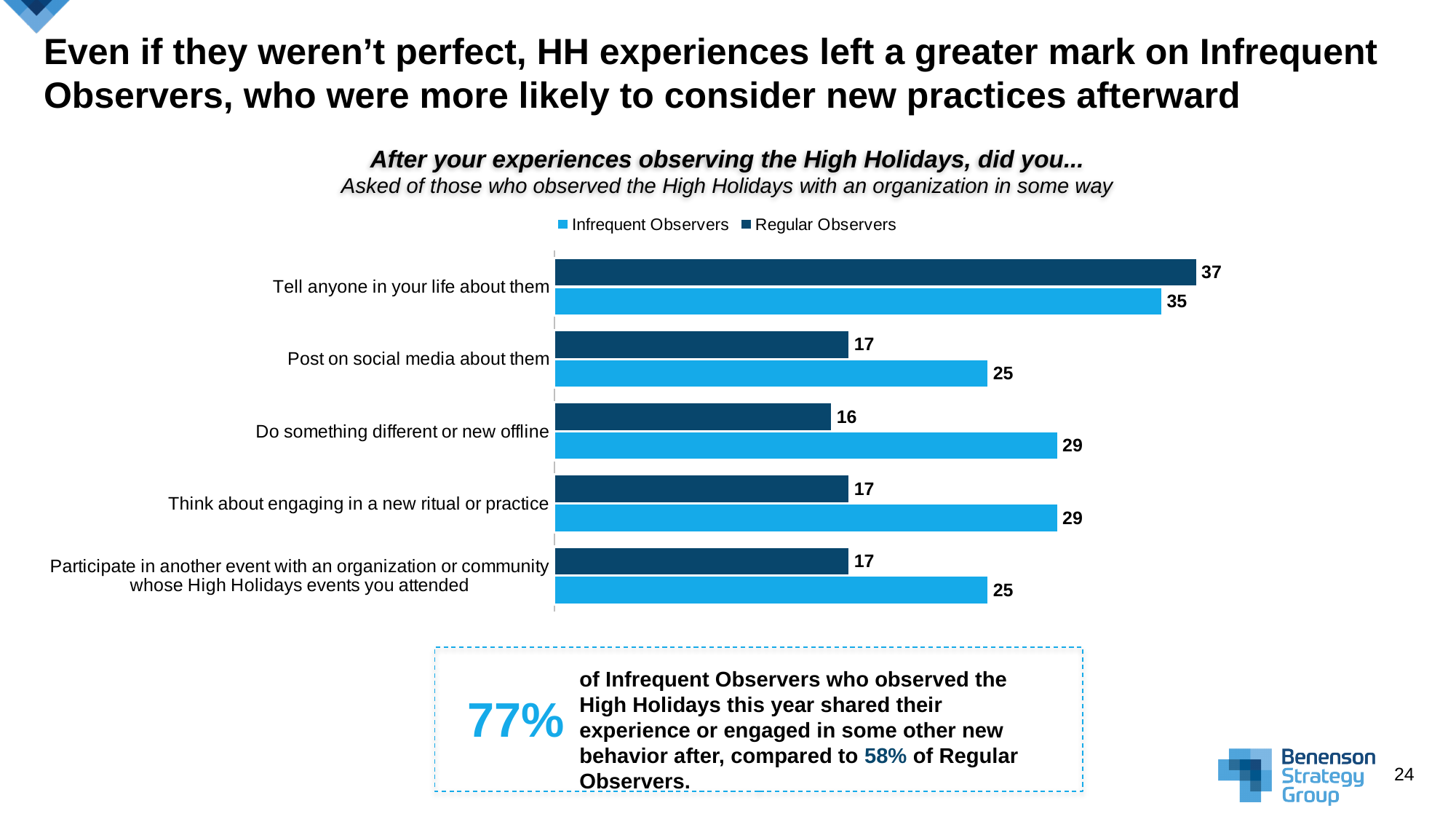
What is the value for Regular Observers for "Think about engaging in a new ritual or practice"? 17 How many categories are shown in the chart? 5 Which category has the highest value for Infrequent Observers? Tell anyone in your life about them What is the value for Infrequent Observers for "Do something different or new offline"? 29 How many series does the legend list? 2 Which category has the lowest value for Regular Observers? Do something different or new offline What kind of chart is shown on the slide? Bar chart What is the value for Infrequent Observers for "Post on social media about them"? 25 Which series is shown in the darker blue colour? Regular Observers What is the difference between Infrequent Observers and Regular Observers for "Do something different or new offline"? 13 What is the value for Regular Observers for "Tell anyone in your life about them"? 37 Which is larger for "Post on social media about them": Infrequent Observers or Regular Observers? Infrequent Observers